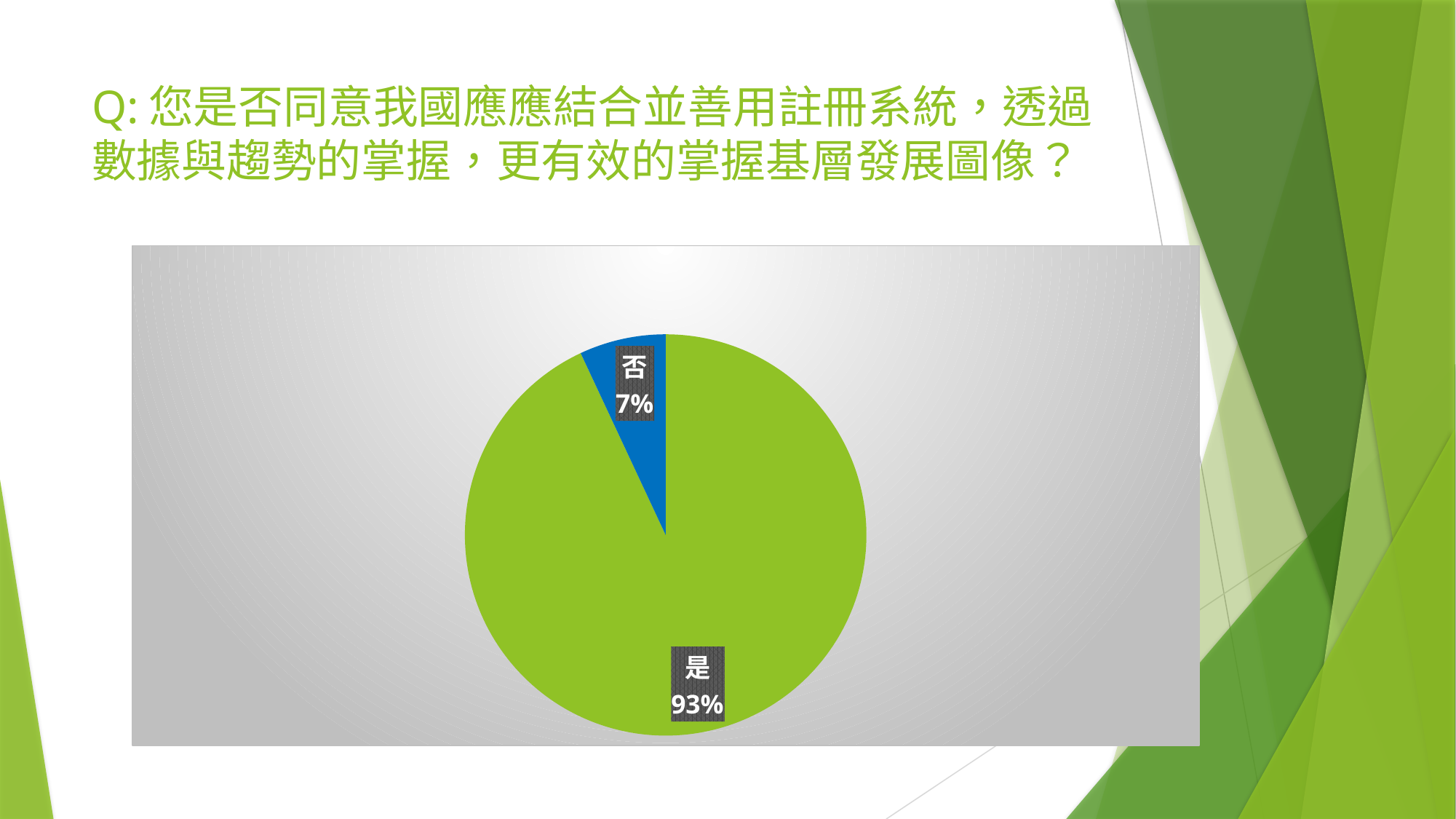
Which slice is larger, 是 or 否? 是 What kind of chart is shown on the slide? pie chart What colour is the 否 slice of the pie? blue What colour is the 是 slice of the pie? green What percentage of the pie is labelled 否? 7% What percentage of the pie is labelled 是? 93% Which slice of the pie is the smallest? 否 What is the difference in percentage points between the 是 slice and the 否 slice? 86 How many slices does the pie chart have? 2 Which slice of the pie is the largest? 是 What share of the pie does the 否 slice represent? 7%